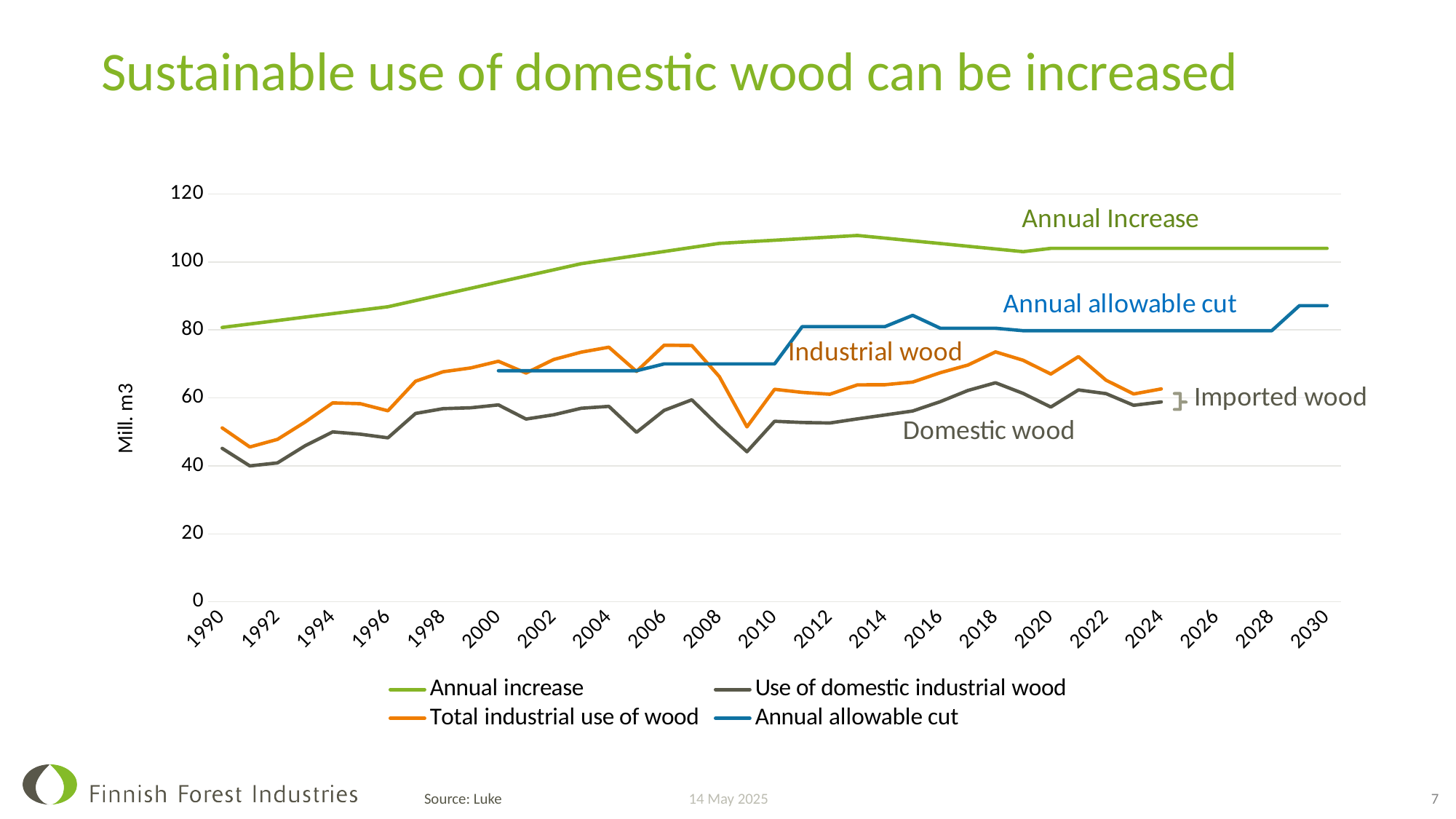
Is the value for Annual allowable cut in 2000 greater or less than 80? less Is the value for Annual increase in 2018 greater or less than 100? greater Which series has the highest values across the whole chart? Annual increase How many series does the legend list? 4 Is the value for Annual allowable cut in 2030 greater or less than 80? greater What kind of chart is shown on the slide? line chart In 2006, which is higher: Total industrial use of wood or Use of domestic industrial wood? Total industrial use of wood Does the Annual increase line rise or fall from 1990 to 2014? rise How many year labels are shown along the x axis? 21 What is the label on the vertical axis? Mill. m3